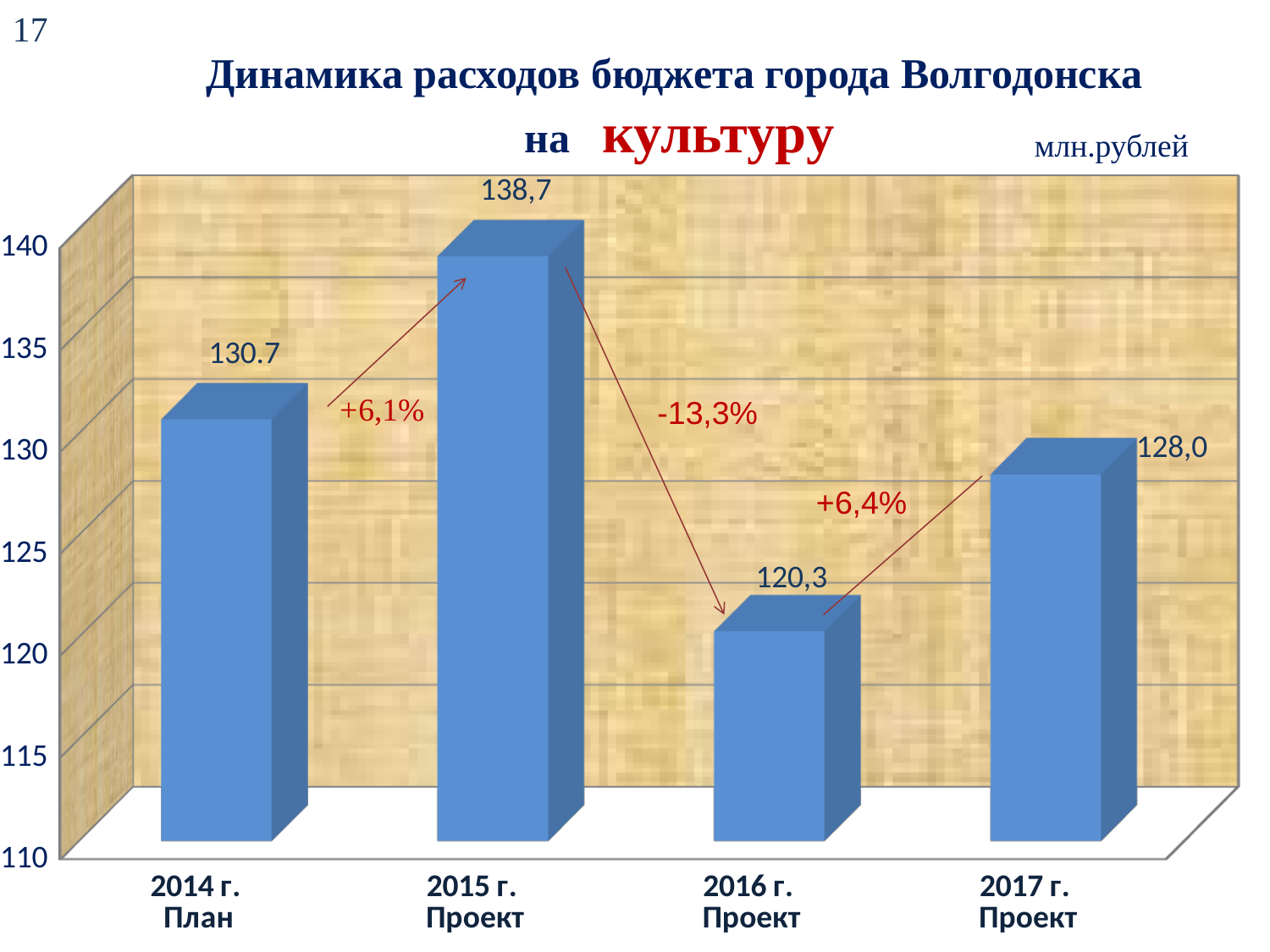
What is the value for 2017 г. Проект? 128,0 What is the difference between the values for 2015 г. Проект and 2016 г. Проект? 18,4 Which is larger, the value for 2014 г. План or the value for 2017 г. Проект? 2014 г. План How many bars are shown in the chart? 4 What percentage change is annotated between 2015 г. Проект and 2016 г. Проект? -13,3% Which year has the highest value? 2015 г. Проект Which year has the lowest value? 2016 г. Проект What is the difference between the values for 2017 г. Проект and 2016 г. Проект? 7,7 What is the value for 2015 г. Проект? 138,7 What is the value for 2016 г. Проект? 120,3 What is the value for 2014 г. План? 130.7 What kind of chart is shown on the slide? Bar chart